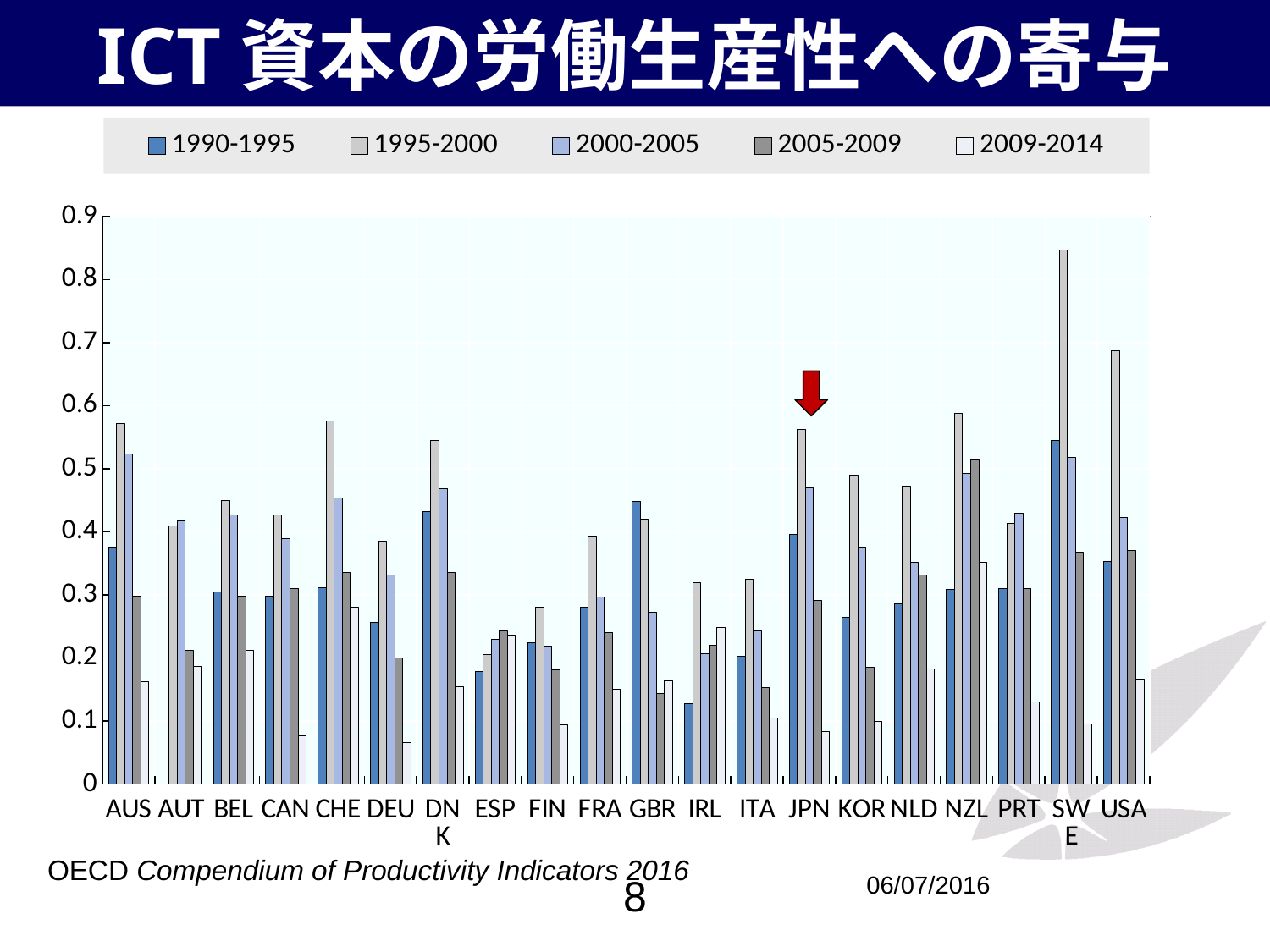
How many countries are shown on the x axis? 20 Which is larger for JPN: the 1995-2000 value or the 2009-2014 value? 1995-2000 What kind of chart is shown on the slide? bar chart Is the 2009-2014 value for CAN greater or less than 0.1? less Which period is listed first in the legend? 1990-1995 Is the 1995-2000 value for JPN greater or less than 0.5? greater Which country has the larger 1990-1995 value, GBR or IRL? GBR Which country has the highest bar in the 1995-2000 series? SWE Which country has the highest bar in the 1990-1995 series? SWE Is the 1995-2000 value for SWE greater or less than 0.8? greater How many series does the legend list? 5